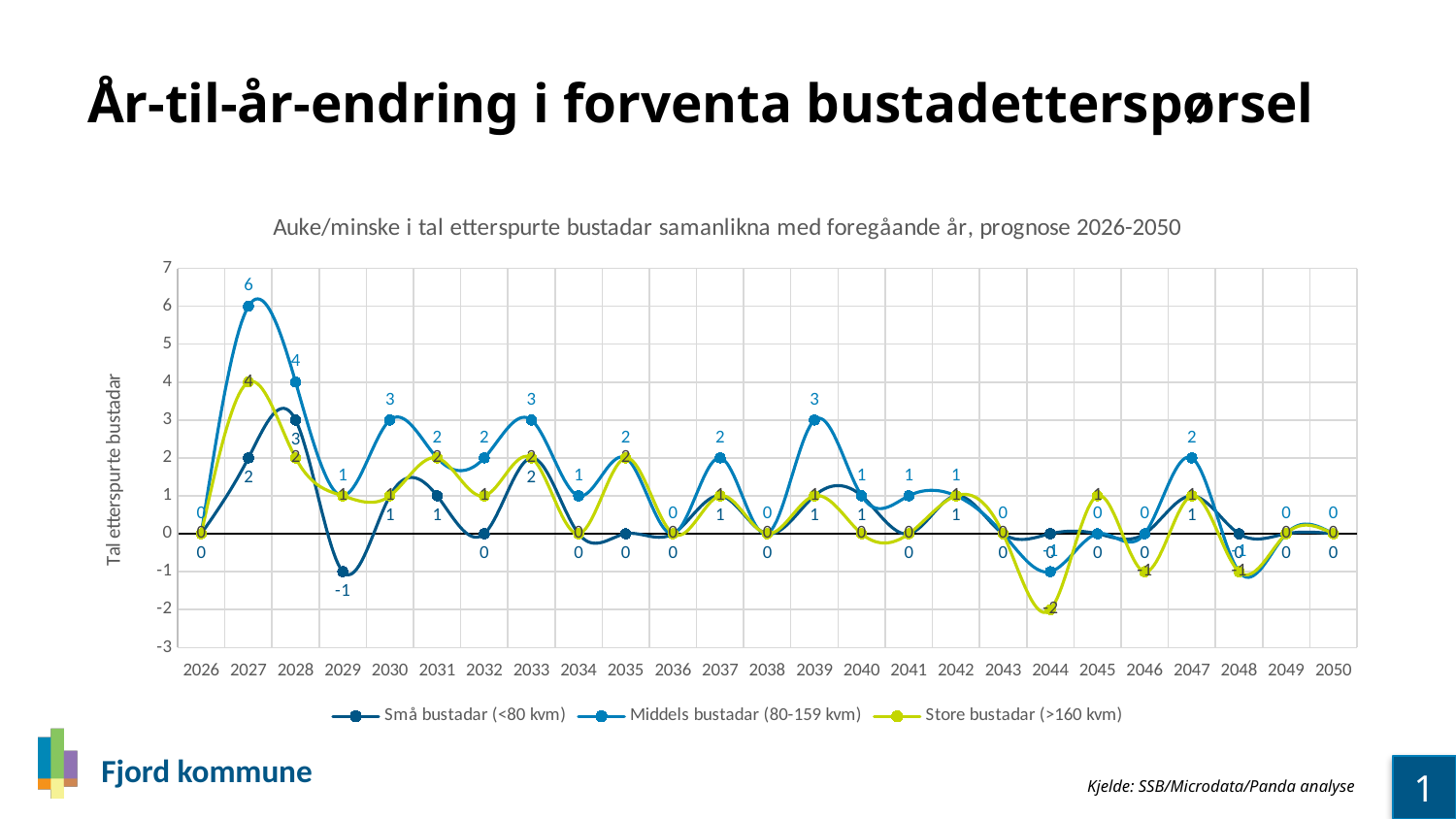
What is the value for Store bustadar (>160 kvm) in 2044? -2 How many years are plotted along the x axis? 25 What type of chart is shown on the slide? Line chart How many series does the legend list? 3 What is the value for Store bustadar (>160 kvm) in 2027? 4 What is the difference between the Middels bustadar (80-159 kvm) value and the Store bustadar (>160 kvm) value in 2027? 2 What is the value for Middels bustadar (80-159 kvm) in 2028? 4 What is the label on the vertical axis of the chart? Tal etterspurte bustadar In which year does Store bustadar (>160 kvm) reach its lowest value? 2044 In which year does Middels bustadar (80-159 kvm) reach its highest value? 2027 In 2047, which series has the higher value: Middels bustadar (80-159 kvm) or Små bustadar (<80 kvm)? Middels bustadar (80-159 kvm) What is the value for Middels bustadar (80-159 kvm) in 2027? 6